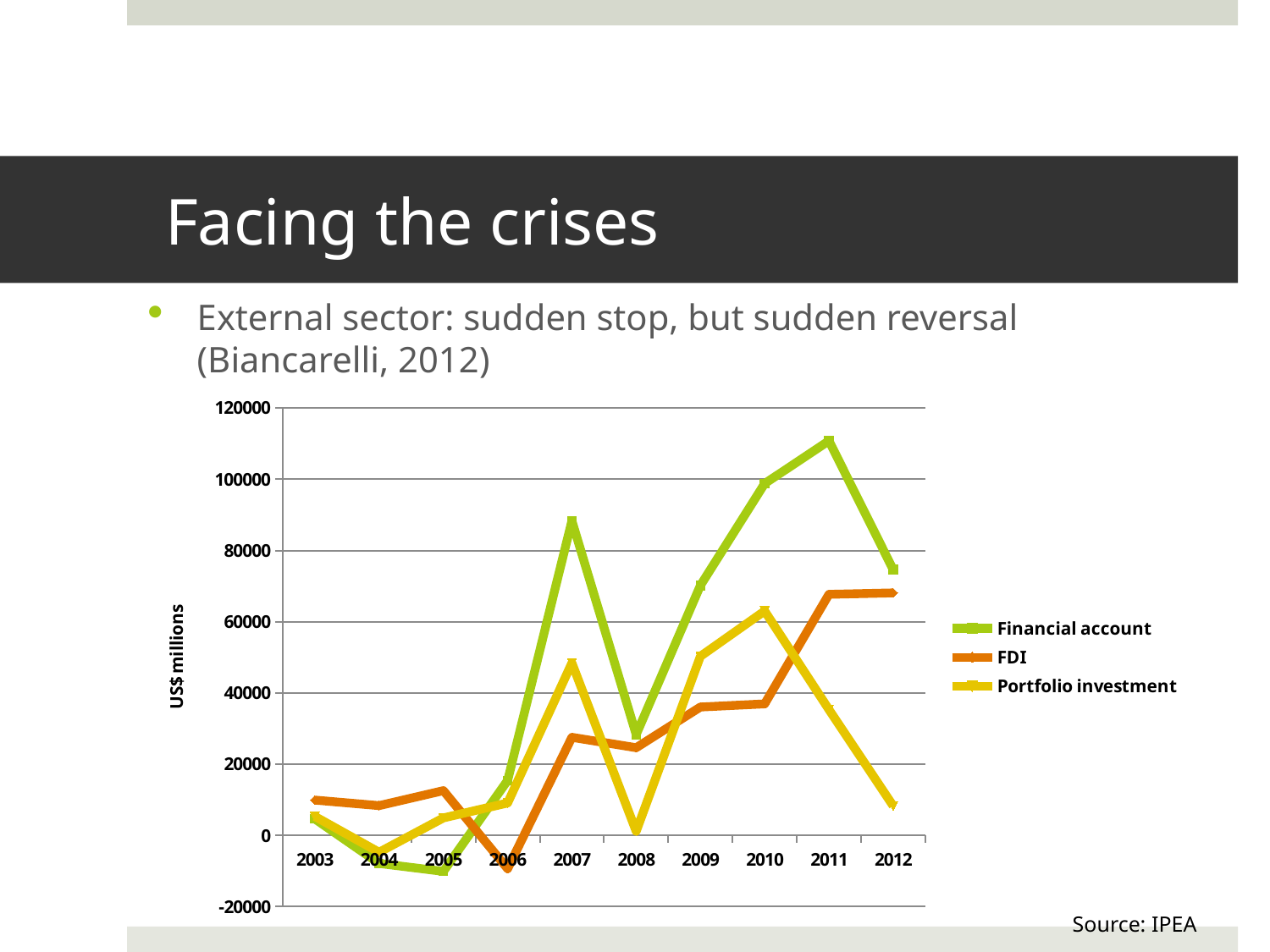
What kind of chart is shown on the slide? line chart In 2011, which is larger: FDI or Portfolio investment? FDI Does the Financial account series rise or fall from 2011 to 2012? fall How many years are shown on the x axis? 10 In which year does the Financial account series reach its lowest value? 2005 Is the FDI value for 2012 greater or less than 60000? greater How many series does the legend list? 3 In 2010, which is larger: Financial account or Portfolio investment? Financial account Is the Portfolio investment value for 2012 greater or less than 20000? less Is the Financial account value for 2011 greater or less than 100000? greater What is the label on the y axis of the chart? US$ millions In which year does the Financial account series reach its highest value? 2011